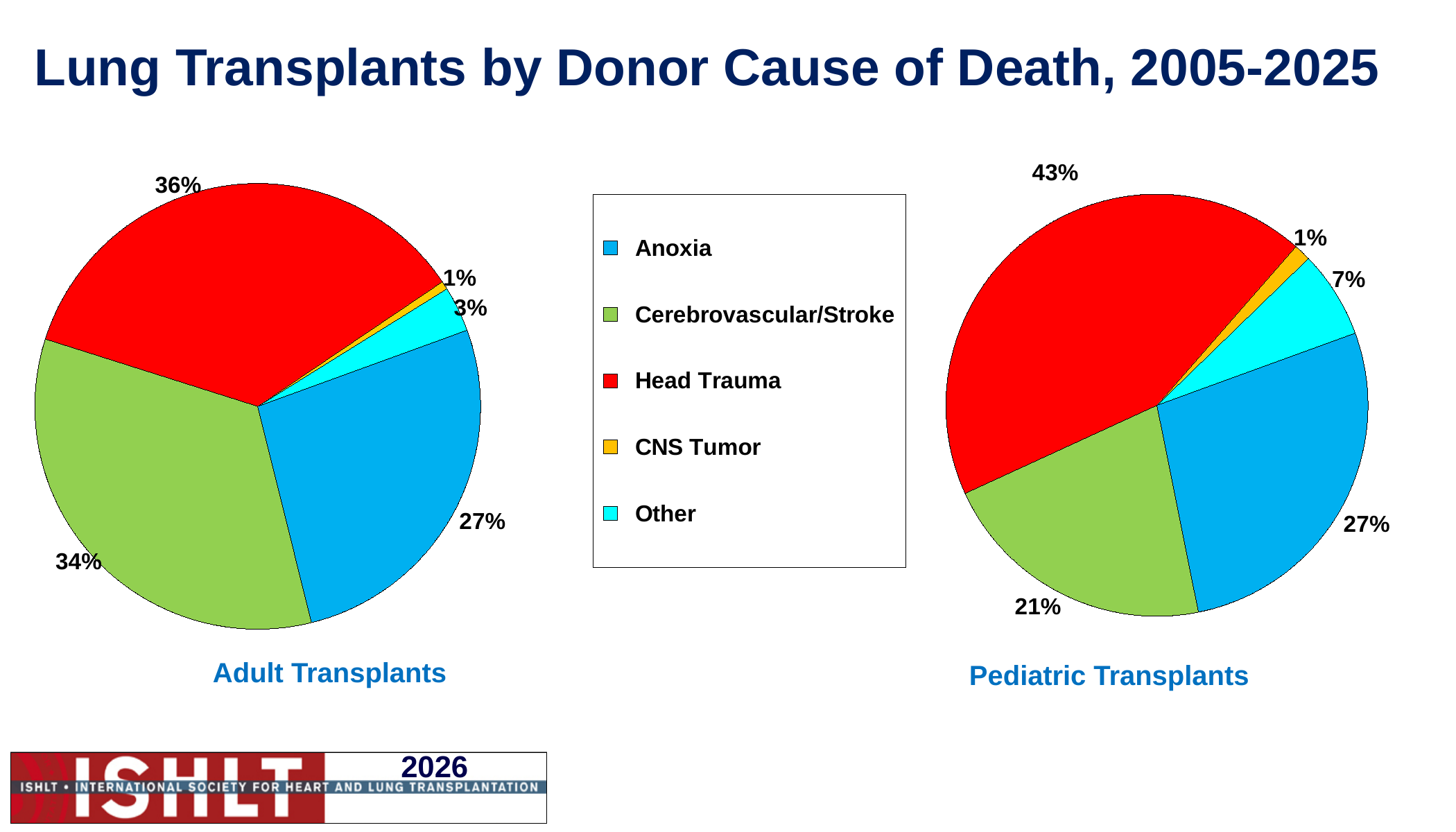
In the Adult Transplants pie chart, which donor cause of death has the smallest slice? CNS Tumor What type of chart is used for the Adult Transplants and Pediatric Transplants data? Pie chart How many donor cause of death categories does the legend list? 5 In the Pediatric Transplants pie chart, what percentage is shown for Head Trauma? 43% In the Pediatric Transplants pie chart, which donor cause of death has the largest slice? Head Trauma In the Adult Transplants pie chart, what share of lung transplants had Head Trauma as the donor cause of death? 36% In the Adult Transplants pie chart, what percentage is shown for Cerebrovascular/Stroke? 34% What is the difference between the Head Trauma share in the Pediatric Transplants chart and the Head Trauma share in the Adult Transplants chart? 7 percentage points Is the Other slice larger in the Adult Transplants chart or the Pediatric Transplants chart? Pediatric Transplants In the Pediatric Transplants pie chart, what share of transplants had Cerebrovascular/Stroke as the donor cause of death? 21% In the Adult Transplants pie chart, what is the difference between the Cerebrovascular/Stroke share and the Anoxia share? 7 percentage points Which colour represents Anoxia in the pie charts? Blue